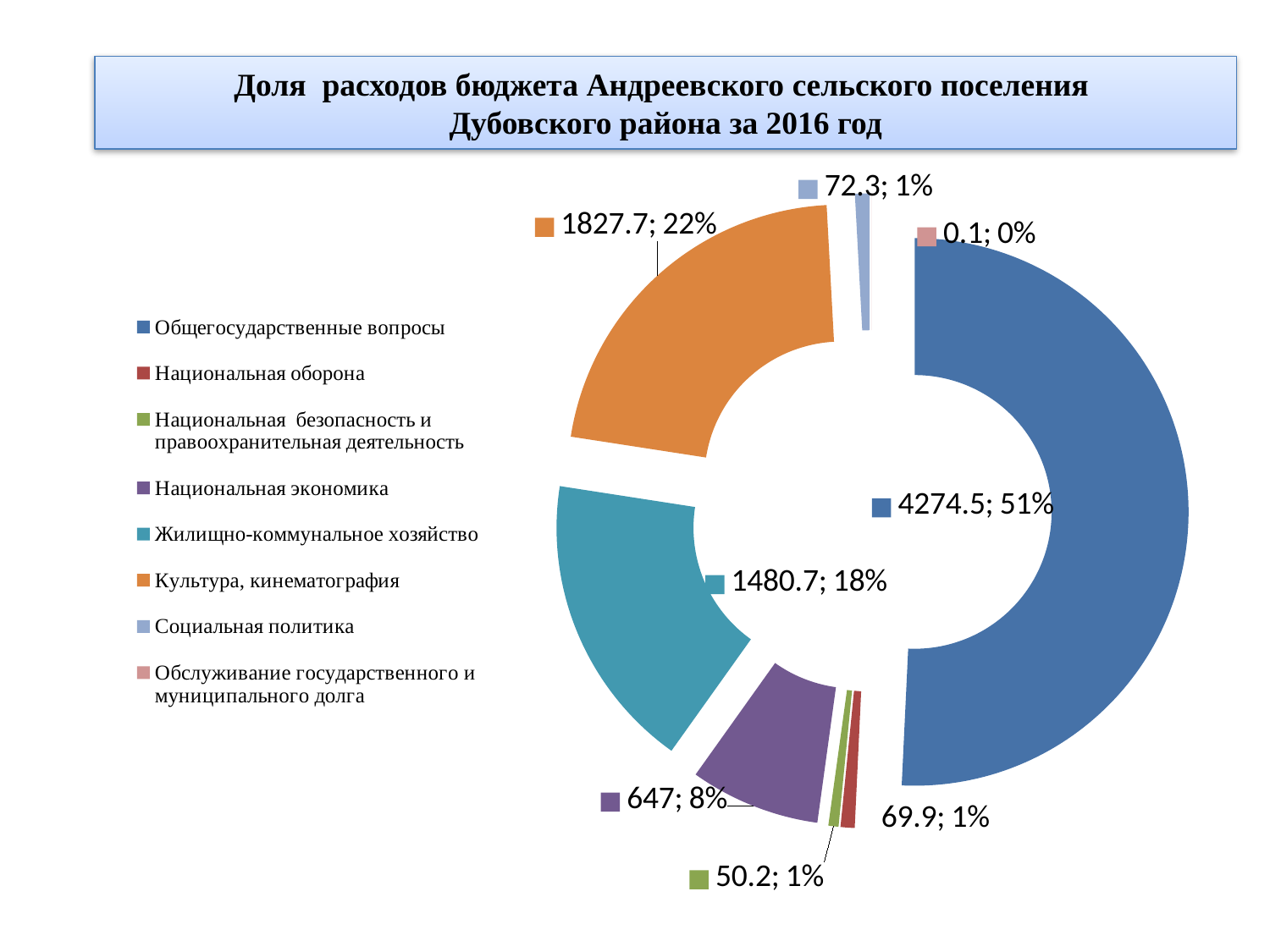
Which is larger: the value for Национальная оборона or the value for Социальная политика? Социальная политика What share of the budget expenditure does Культура, кинематография account for? 22% What type of chart is shown on the slide? Doughnut (pie) chart How many categories does the chart show? 8 Which category has the largest share of expenditure? Общегосударственные вопросы What is the value for Общегосударственные вопросы? 4274.5 What is the title of the chart? Доля расходов бюджета Андреевского сельского поселения Дубовского района за 2016 год What share of expenditure does Национальная экономика account for? 8% What is the value for Жилищно-коммунальное хозяйство? 1480.7 What is the value for Национальная экономика? 647 What is the difference between the values for Культура, кинематография and Жилищно-коммунальное хозяйство? 347 Which category has the smallest value? Обслуживание государственного и муниципального долга